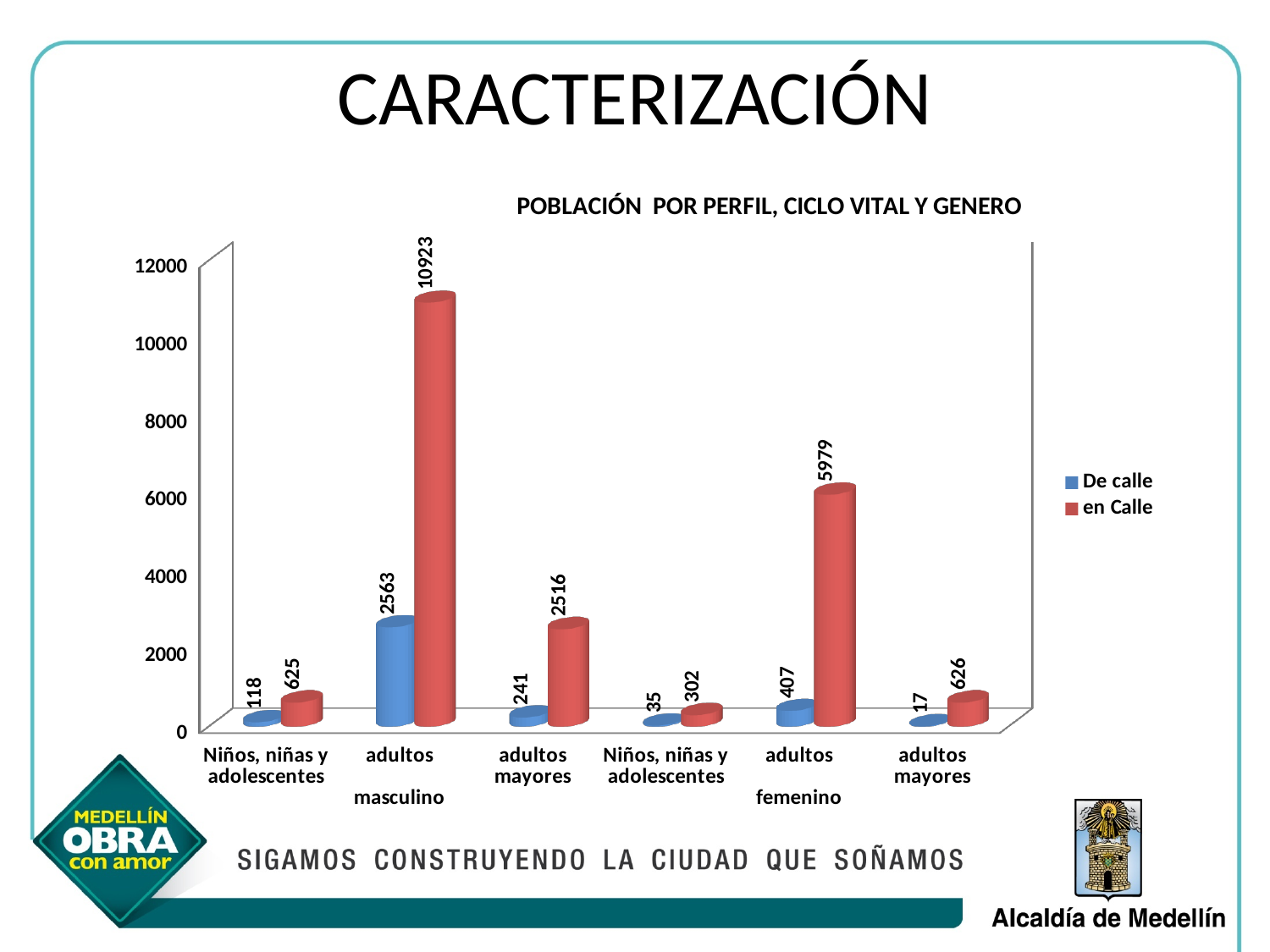
How many categories are shown on the x axis? 6 Which is larger: the 'De calle' value for adultos masculino or the 'en Calle' value for adultos mayores masculino? De calle for adultos masculino What is the value of 'De calle' for Niños, niñas y adolescentes femenino? 35 What is the title of the chart? POBLACIÓN POR PERFIL, CICLO VITAL Y GENERO Which category has the lowest 'De calle' value? adultos mayores femenino What is the value of 'De calle' for adultos femenino? 407 What kind of chart is shown on the slide? Bar chart What is the value of 'en Calle' for adultos mayores masculino? 2516 Which category has the highest 'en Calle' value? adultos masculino What is the value of 'en Calle' for adultos masculino? 10923 How many series does the legend list? 2 What is the difference between the 'en Calle' values for adultos masculino and adultos femenino? 4944